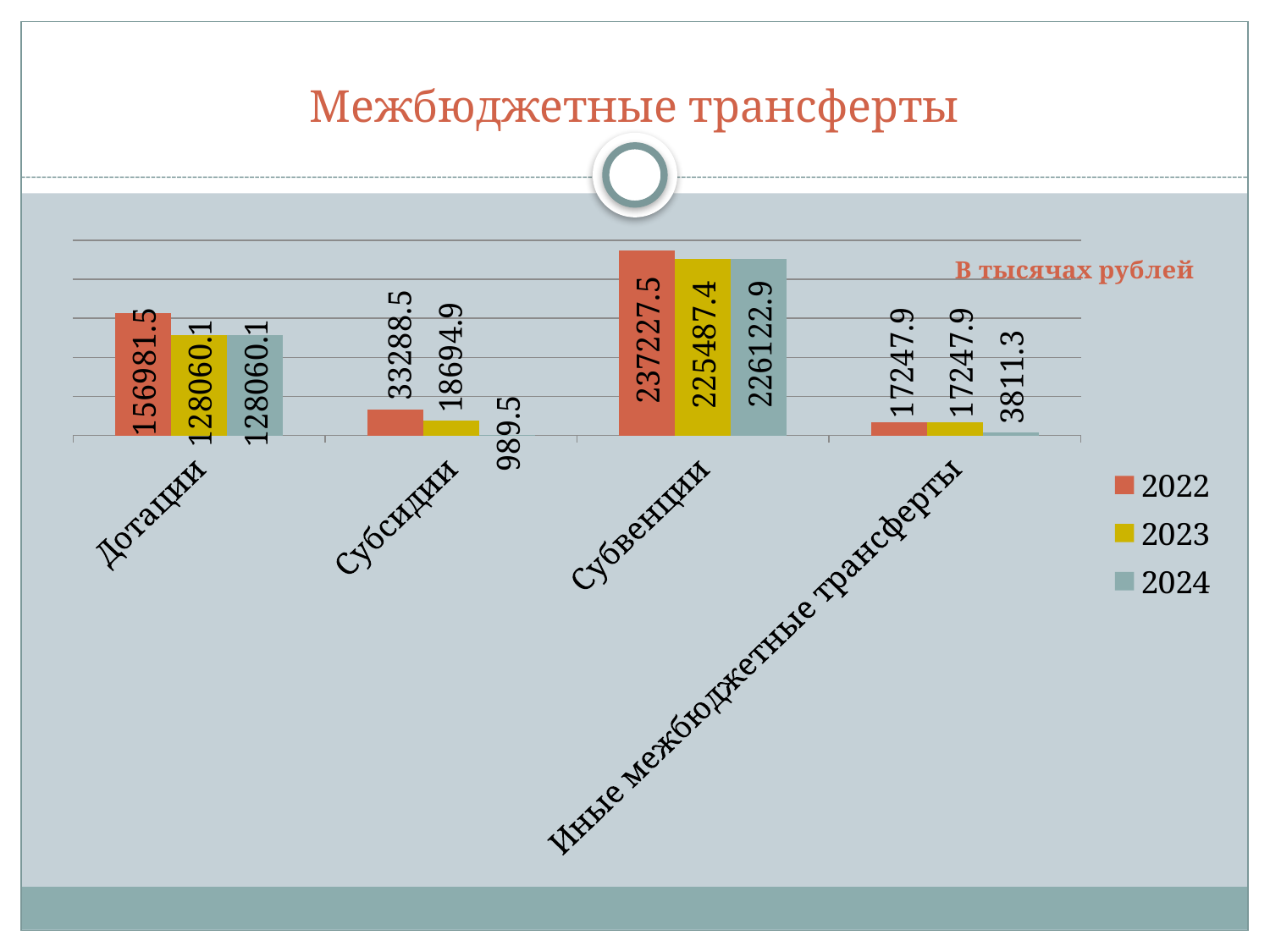
What is the value for Иные межбюджетные трансферты in 2024? 3811.3 What is the value for Субвенции in 2023? 225487.4 How many series does the legend list? 3 What is the difference between the 2023 and 2024 values for Иные межбюджетные трансферты? 13436.6 Which category has the highest value in 2022? Субвенции What is the value for Субсидии in 2024? 989.5 What kind of chart is shown on the slide? Bar chart What is the difference between the 2022 and 2023 values for Дотации? 28921.4 How many categories are shown on the x axis? 4 What is the value for Дотации in 2022? 156981.5 Which category has the lowest value in 2024? Субсидии Which is larger for Субвенции: the 2023 value or the 2024 value? 2024